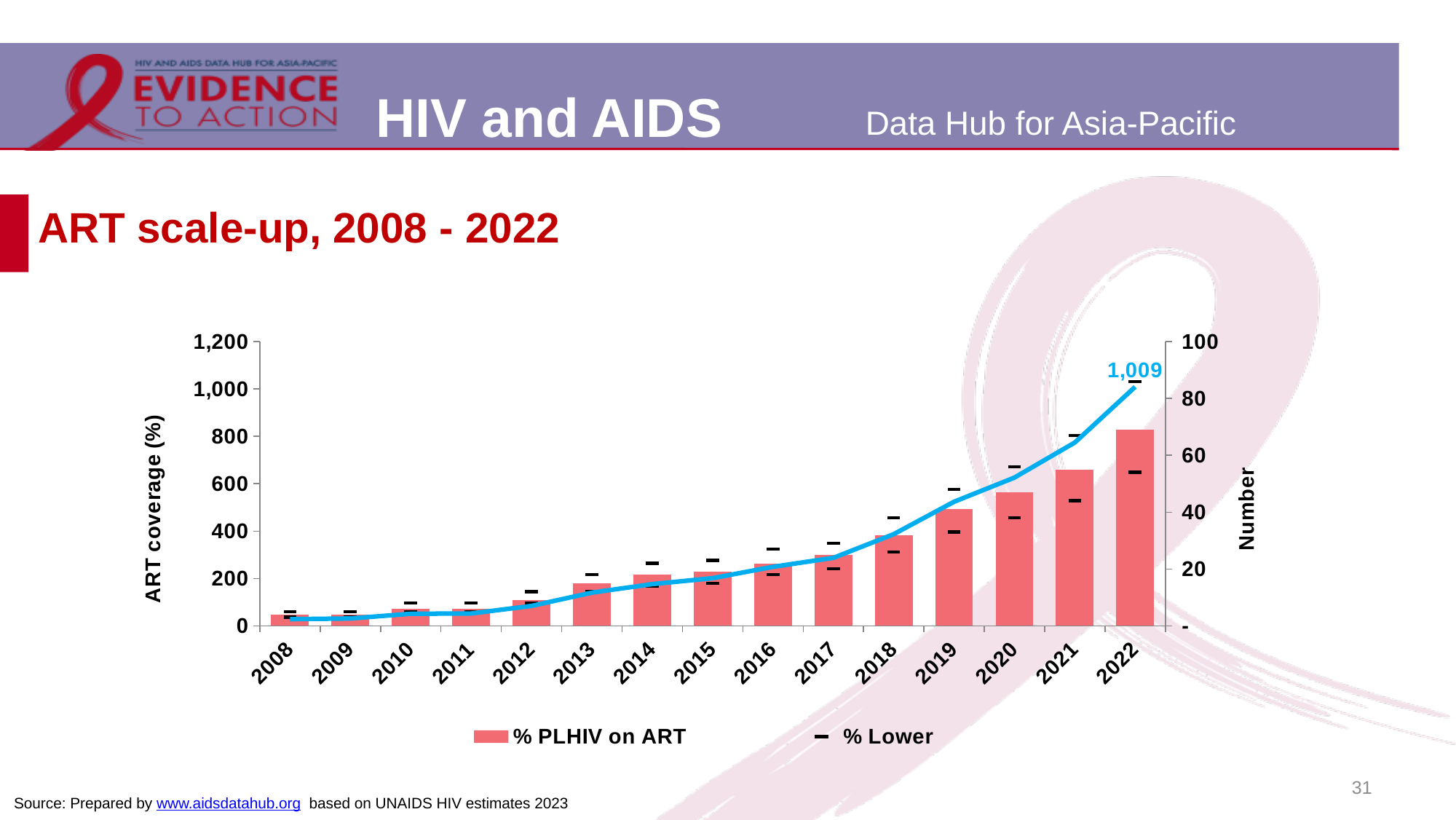
What kind of chart is this? Bar chart combined with a line Which year has the tallest bar for % PLHIV on ART? 2022 What is the label on the left vertical axis? ART coverage (%) Do the bars for % PLHIV on ART rise or fall from 2008 to 2022? Rise What value is printed as the data label on the line for 2022? 1,009 Is the bar for 2022 greater or less than 600 on the left axis? greater Is the line value for 2017 greater or less than 400 on the left axis? less What is the title of the chart? ART scale-up, 2008 - 2022 Is the bar for 2018 greater or less than 200 on the left axis? greater How many years are shown along the x axis? 15 Which bar is taller, 2021 or 2019? 2021